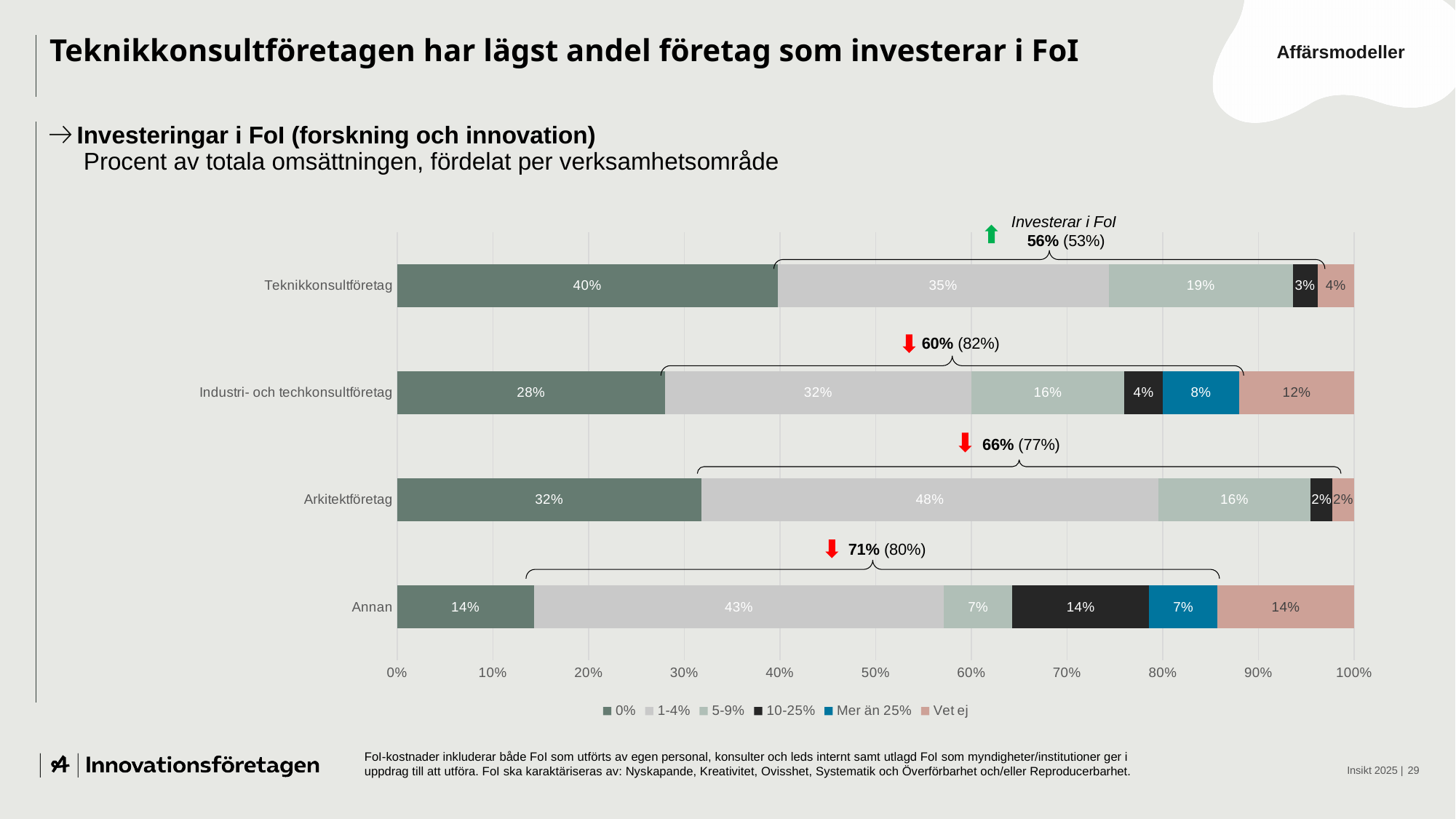
What is the value of the 0% segment for Teknikkonsultföretag? 40% How many categories (verksamhetsområden) are plotted on the chart? 4 Which is larger: the 5-9% segment for Teknikkonsultföretag or the 5-9% segment for Annan? Teknikkonsultföretag What is the value of the Vet ej segment for Annan? 14% Which category has the lowest value for the 0% segment? Annan How many series does the legend list? 6 What is the value of the 1-4% segment for Arkitektföretag? 48% What kind of chart is shown on the slide? Stacked bar chart Which category has the highest value for the 0% segment? Teknikkonsultföretag What is the difference between the 1-4% segment for Arkitektföretag and the 1-4% segment for Teknikkonsultföretag? 13% What is the value of the Mer än 25% segment for Industri- och techkonsultföretag? 8% What share of companies investing in FoI (Investerar i FoI) is annotated for Teknikkonsultföretag? 56% (53%)